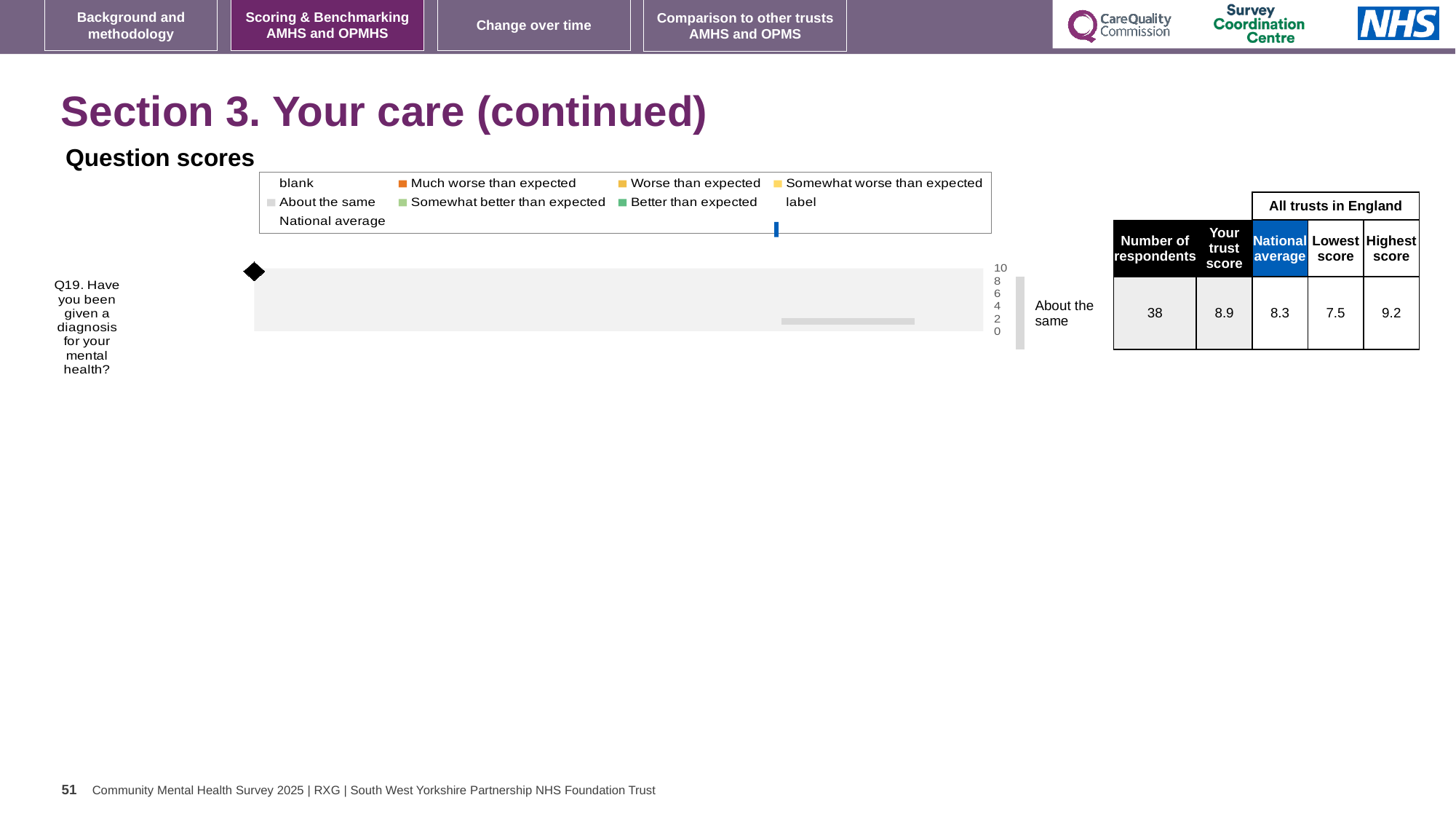
Which is larger for Q19, the trust score or the national average? trust score What is the lowest score among all trusts in England for Q19? 7.5 What kind of chart is shown under 'Question scores'? bar chart How many respondents answered Q19? 38 What benchmark category is shown for Q19 in the Question scores chart? About the same What is the highest score among all trusts in England for Q19? 9.2 What is the trust score for Q19? 8.9 What is the difference between the highest and lowest scores for Q19? 1.7 What is the national average score for Q19? 8.3 What is the difference between the trust score and the national average for Q19? 0.6 Which question is plotted in the Question scores chart? Q19. Have you been given a diagnosis for your mental health? How many questions are plotted in the Question scores chart? 1